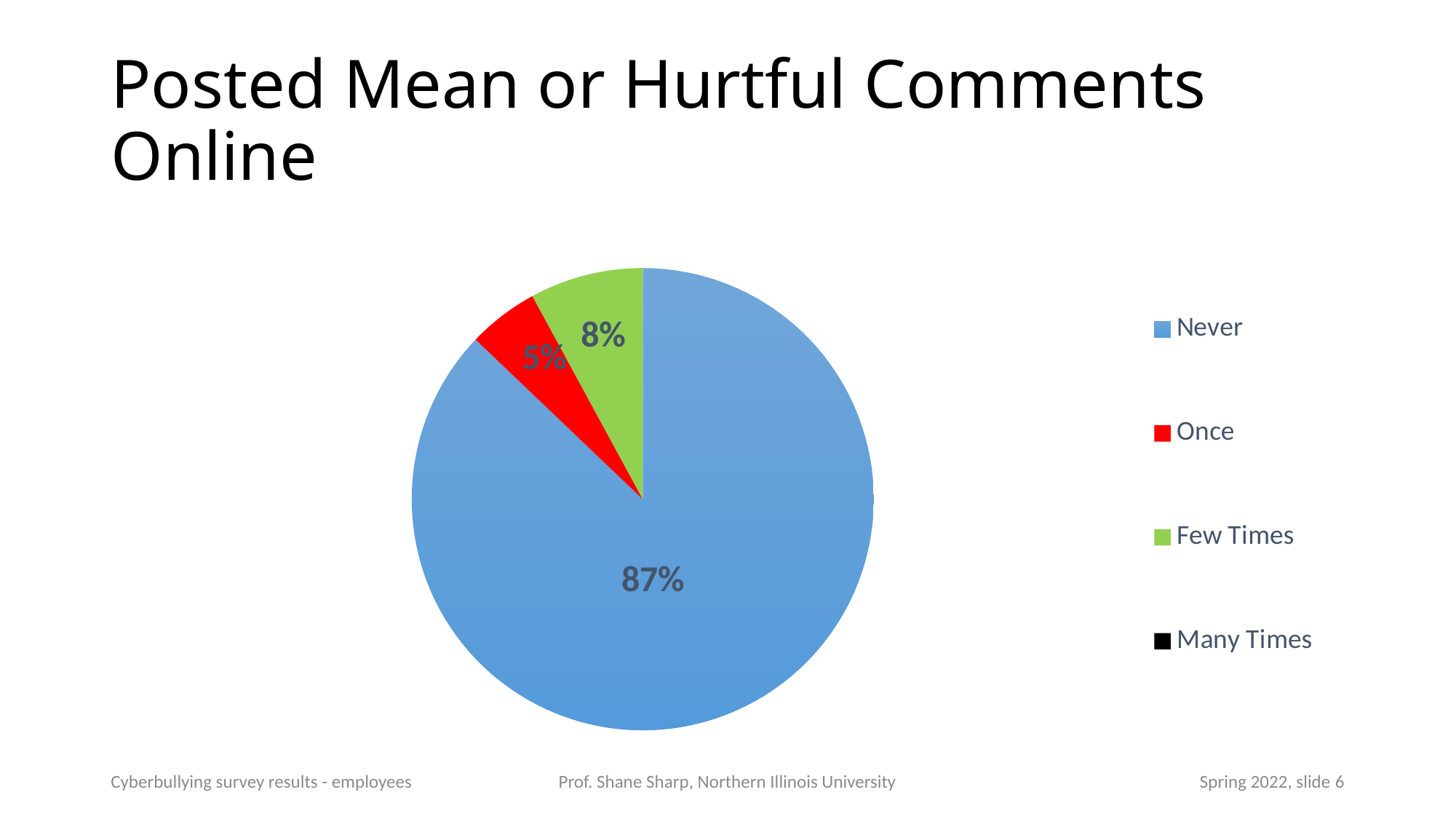
Which of the labelled slices is the smallest? Once What is the difference in percentage points between "Few Times" and "Once"? 3 How many entries does the legend list? 4 Which is larger, the share for "Once" or the share for "Few Times"? Few Times What colour is the "Once" slice? Red What percentage of respondents answered "Once"? 5% What percentage of respondents answered "Never"? 87% Which category has the largest share of the pie? Never What kind of chart is shown on the slide? Pie chart What percentage of respondents answered "Few Times"? 8% What is the title of the slide? Posted Mean or Hurtful Comments Online What is the difference in percentage points between "Never" and "Few Times"? 79